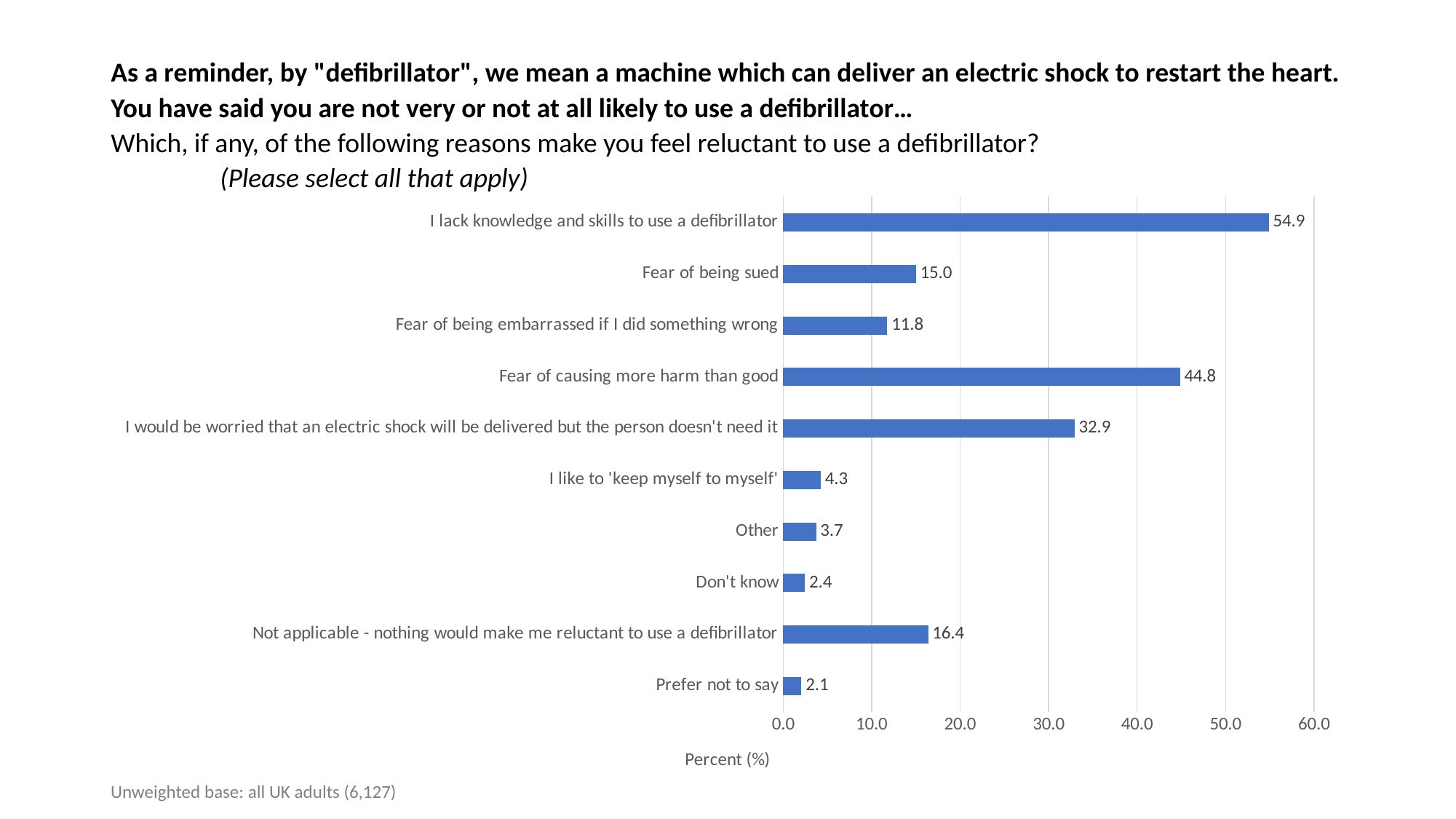
How many categories are shown in the chart? 10 What is the value for "Don't know"? 2.4 What is the value for "Fear of causing more harm than good"? 44.8 Is the value for "I would be worried that an electric shock will be delivered but the person doesn't need it" greater or less than 30.0? greater Which category has the lowest value? Prefer not to say What is the value for "I lack knowledge and skills to use a defibrillator"? 54.9 What is the value for "Not applicable - nothing would make me reluctant to use a defibrillator"? 16.4 Which category has the highest value? I lack knowledge and skills to use a defibrillator What is the difference between the values for "Fear of being sued" and "Fear of being embarrassed if I did something wrong"? 3.2 What kind of chart is shown on the slide? bar chart What is the label of the horizontal axis? Percent (%) Which is larger: the value for "Fear of causing more harm than good" or the value for "I would be worried that an electric shock will be delivered but the person doesn't need it"? Fear of causing more harm than good